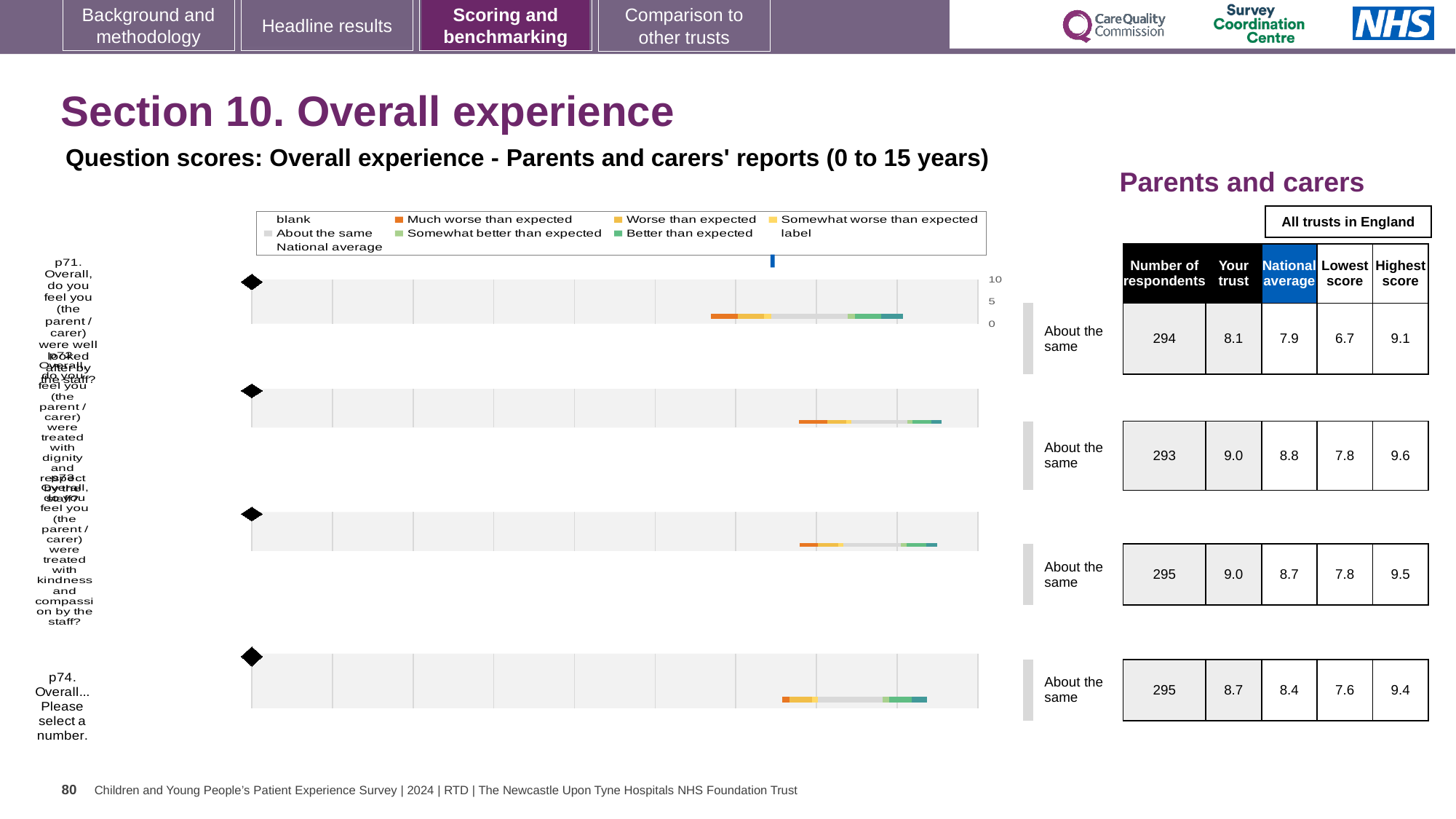
What kind of chart is used to show the question scores for Overall experience? bar chart In the chart legend, which category is shown in orange? Much worse than expected What benchmark category is shown for p73 (treated with kindness and compassion)? About the same Is the 'Your trust' score for p72 greater or less than 5? greater For p71, which is larger: the 'Your trust' score or the national average? Your trust How many questions (rows) are plotted in the Overall experience chart? 4 Which question has the highest 'Highest score' value in the table? p72 Which question has the lowest 'Lowest score' value in the table? p71 What is the difference between the 'Your trust' score and the national average for p74? 0.3 According to the table beside the chart, what is the national average for p72 (treated with dignity and respect)? 8.8 According to the table beside the chart, what is the 'Your trust' score for p74 (Overall... Please select a number)? 8.7 How many respondents are listed for p71 (were well looked after by the staff)? 294